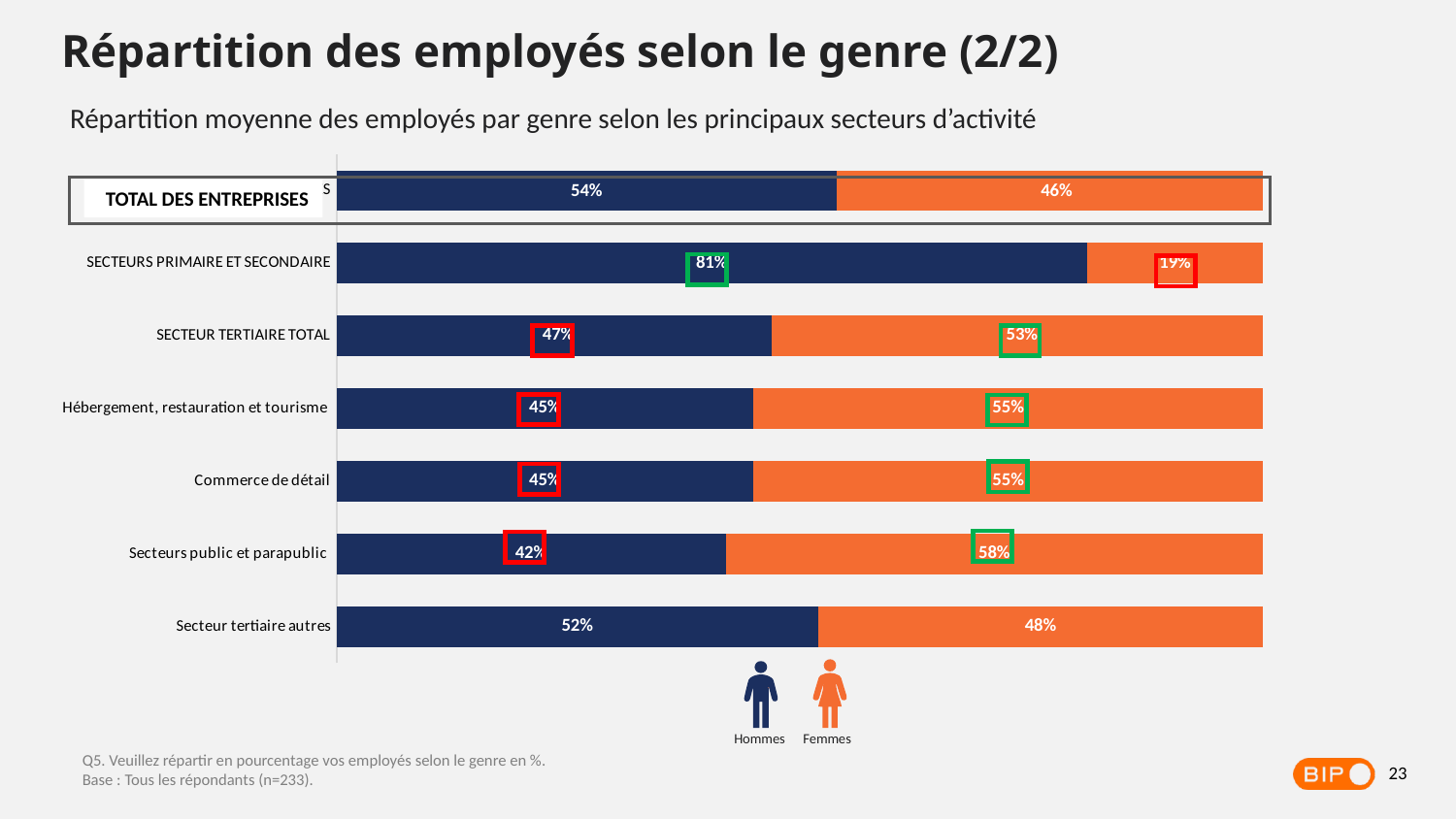
Which is larger in SECTEUR TERTIAIRE TOTAL: the share of Hommes or the share of Femmes? Femmes What is the share of Femmes for Secteur tertiaire autres? 48% What percentage of employees are men (Hommes) in SECTEURS PRIMAIRE ET SECONDAIRE? 81% Which colour represents Femmes in the chart? Orange Which sector has the lowest share of Hommes? Secteurs public et parapublic What is the share of Hommes for TOTAL DES ENTREPRISES? 54% Which sector has the highest share of Hommes? SECTEURS PRIMAIRE ET SECONDAIRE What type of chart is shown on the slide? Stacked bar chart How many series does the legend list? 2 What percentage of employees are women (Femmes) in Secteurs public et parapublic? 58% How many sector categories are shown in the chart? 7 What is the difference between the Hommes share and the Femmes share in SECTEURS PRIMAIRE ET SECONDAIRE? 62 percentage points